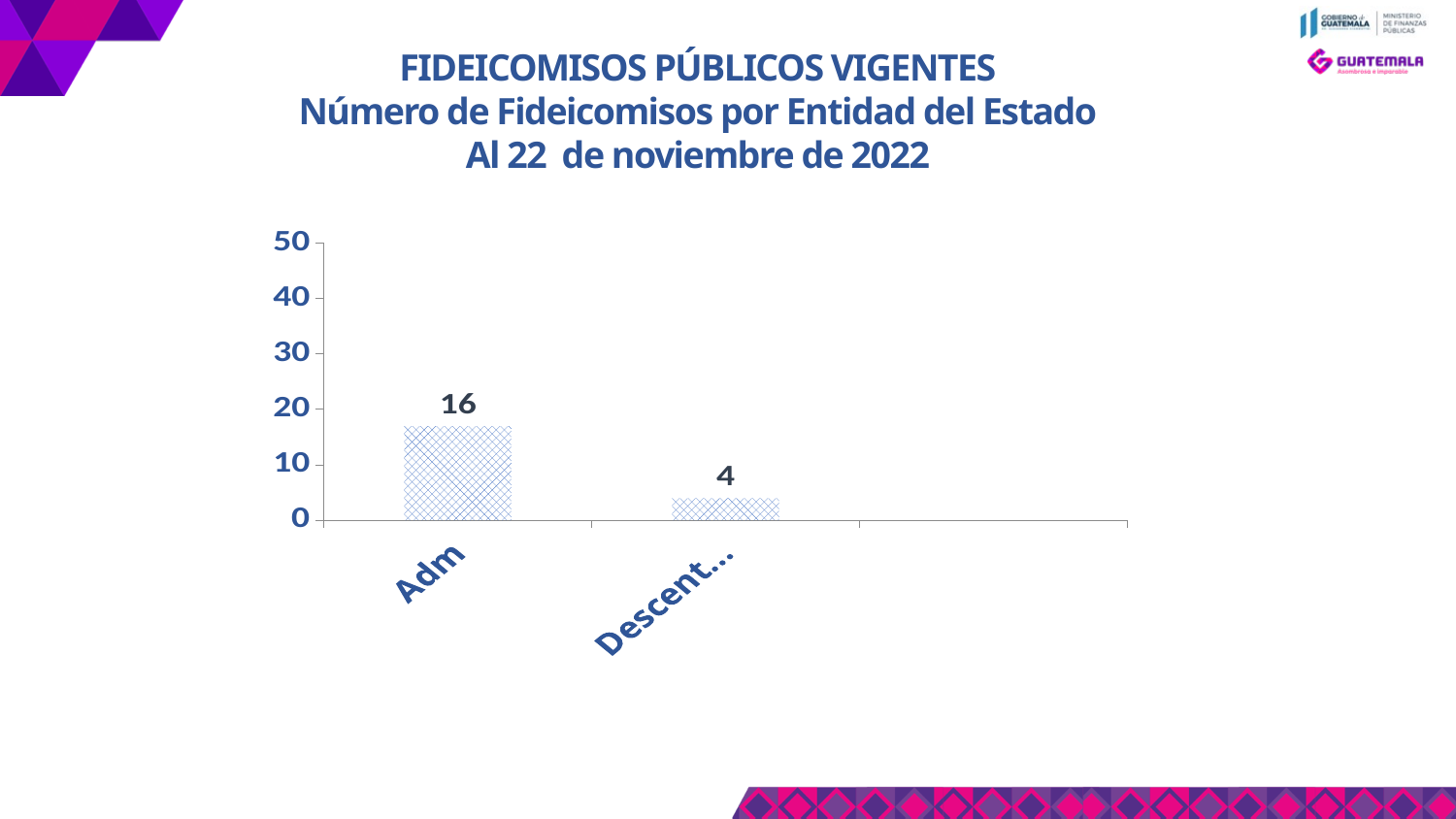
What is the value of the bar labelled "Adm"? 16 Is the value for "Descent..." greater or less than 10? less Which category has the lowest value? Descent... What is the highest value shown on the vertical axis? 50 What is the difference between the values for "Adm" and "Descent..."? 12 Which is larger, the value for "Adm" or the value for "Descent..."? Adm Is the value for "Adm" greater or less than 10? greater What kind of chart is shown on the slide? bar chart What is the value of the bar labelled "Descent..."? 4 Which category has the highest value? Adm How many bars are plotted in the chart? 2 What date does the chart title say the data is as of? 22 de noviembre de 2022